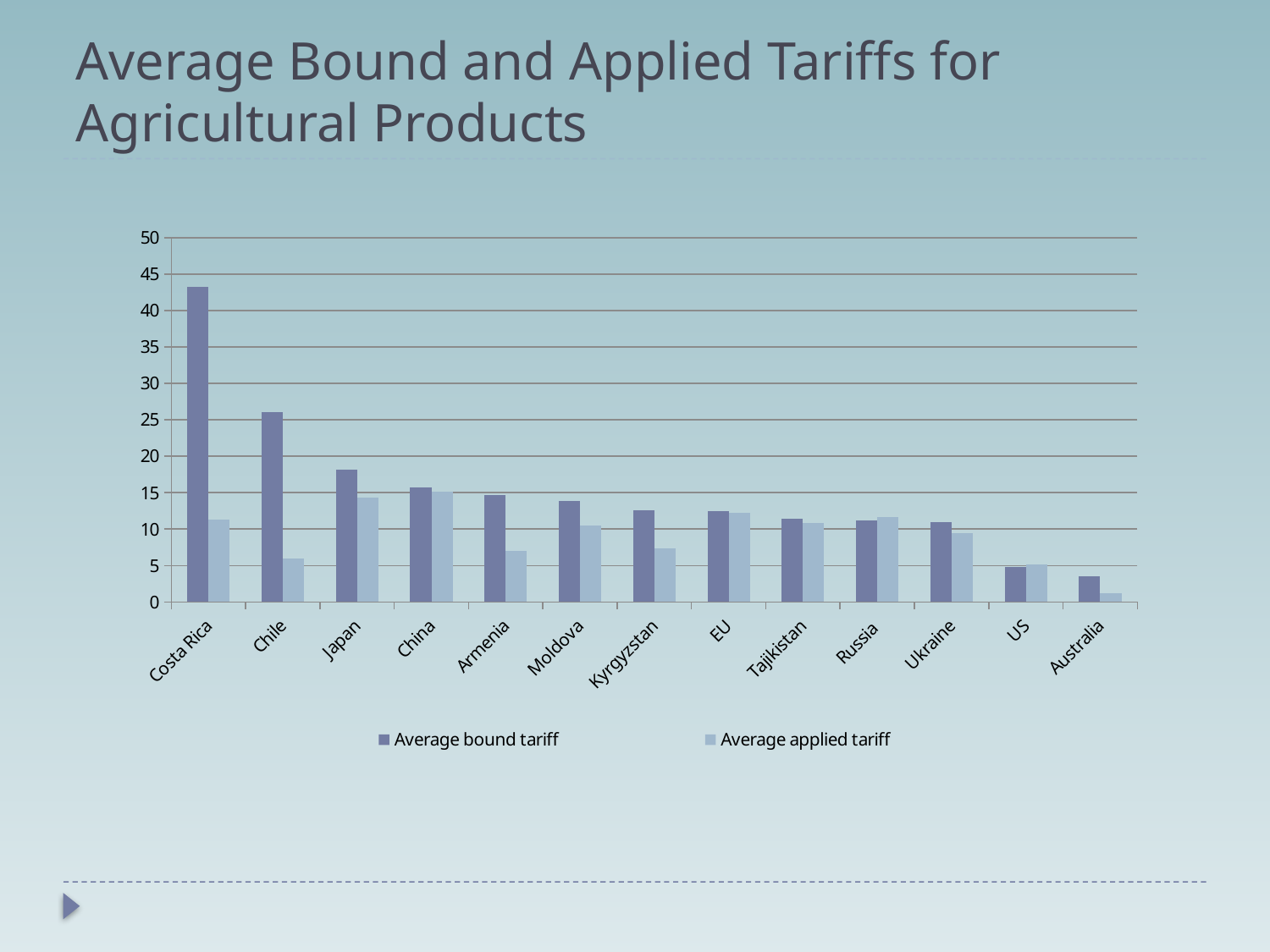
For Chile, which is larger: the average bound tariff or the average applied tariff? Average bound tariff Do the average bound tariff values rise or fall moving from left to right along the x axis? fall Which country has the lowest average applied tariff? Australia How many countries/regions are shown on the x axis? 13 How many series does the legend list? 2 Is the average bound tariff for the US greater or less than 10? less Is the average applied tariff for Armenia greater or less than 10? less Which country has the highest average bound tariff? Costa Rica Is the average bound tariff for Japan greater or less than 20? less Which country has the lowest average bound tariff? Australia What kind of chart is shown on the slide? bar chart